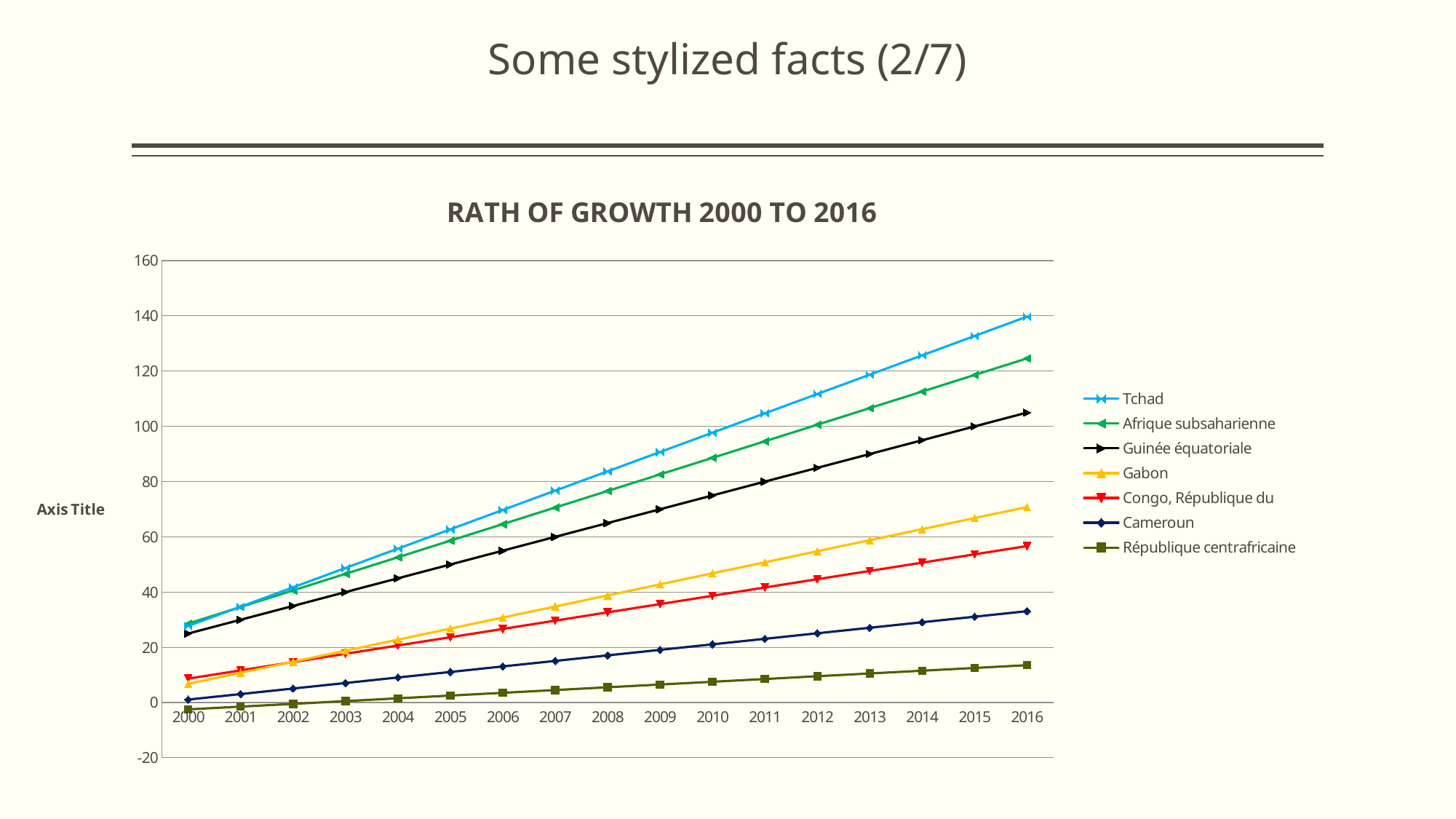
Which series has the lowest value in 2016? République centrafricaine Do the values for Afrique subsaharienne rise or fall from 2000 to 2016? rise Is the value for République centrafricaine in 2016 greater or less than 20? less How many years are plotted along the x axis? 17 Which series has the highest value in 2016? Tchad Is the value for Guinée équatoriale in 2016 greater or less than 100? greater How many series does the legend list? 7 Is the value for Congo, République du in 2016 greater or less than 60? less What kind of chart is shown on the slide? line chart In 2016, which is larger: the value for Gabon or the value for Cameroun? Gabon What is the title of the chart? RATH OF GROWTH 2000 TO 2016